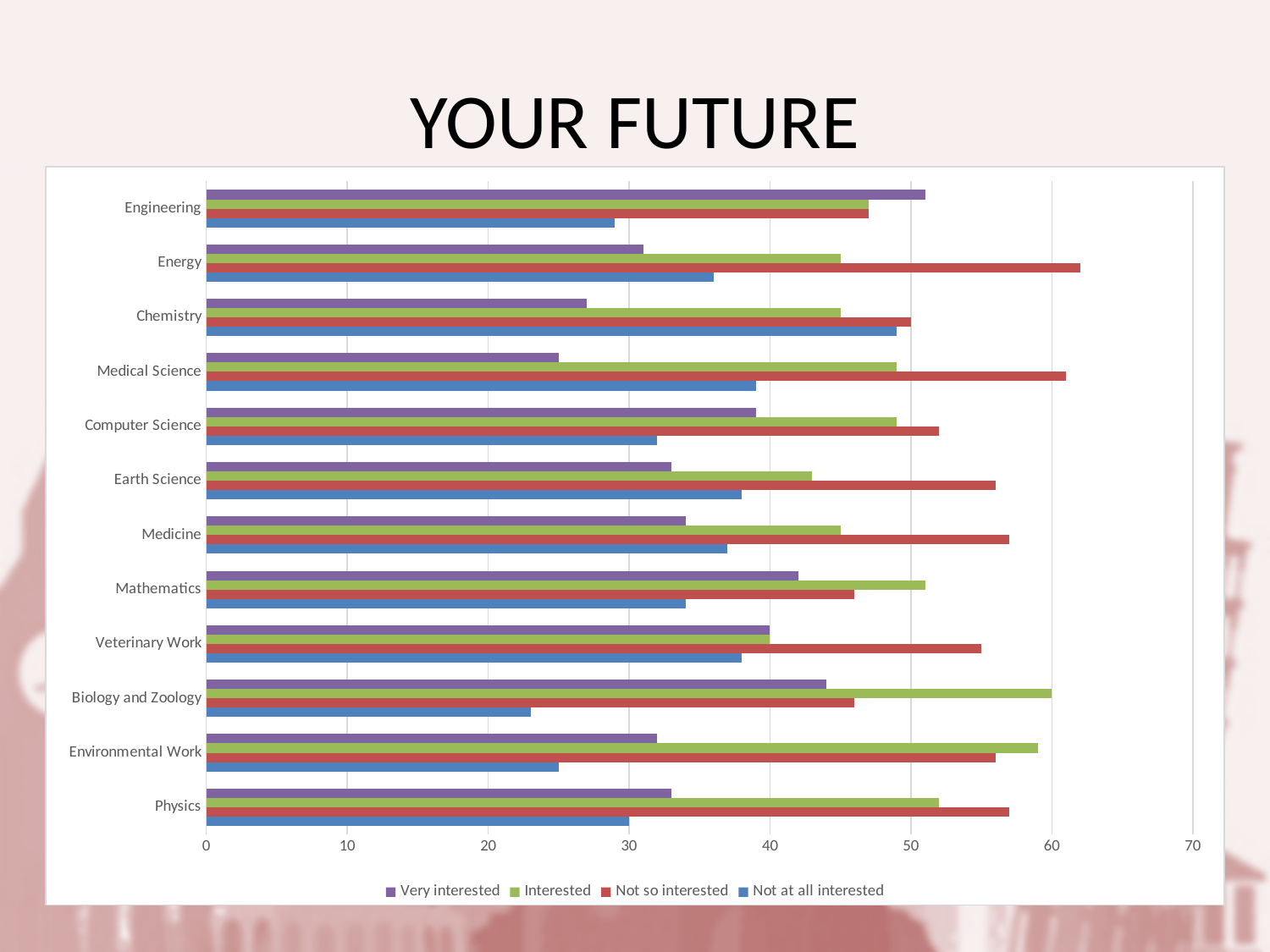
For Engineering, which is larger: the 'Very interested' value or the 'Not at all interested' value? Very interested For Energy, which series has the highest value? Not so interested What kind of chart is shown on the slide? bar chart Which category has the highest 'Very interested' value? Engineering How many series does the legend list? 4 Is the 'Not at all interested' value for Biology and Zoology greater or less than 30? less Is the 'Very interested' value for Engineering greater or less than 40? greater For Biology and Zoology, which is larger: the 'Interested' value or the 'Not at all interested' value? Interested What is the title of the slide containing the chart? YOUR FUTURE Is the 'Not so interested' value for Energy greater or less than 60? greater How many categories (fields) are listed on the chart? 12